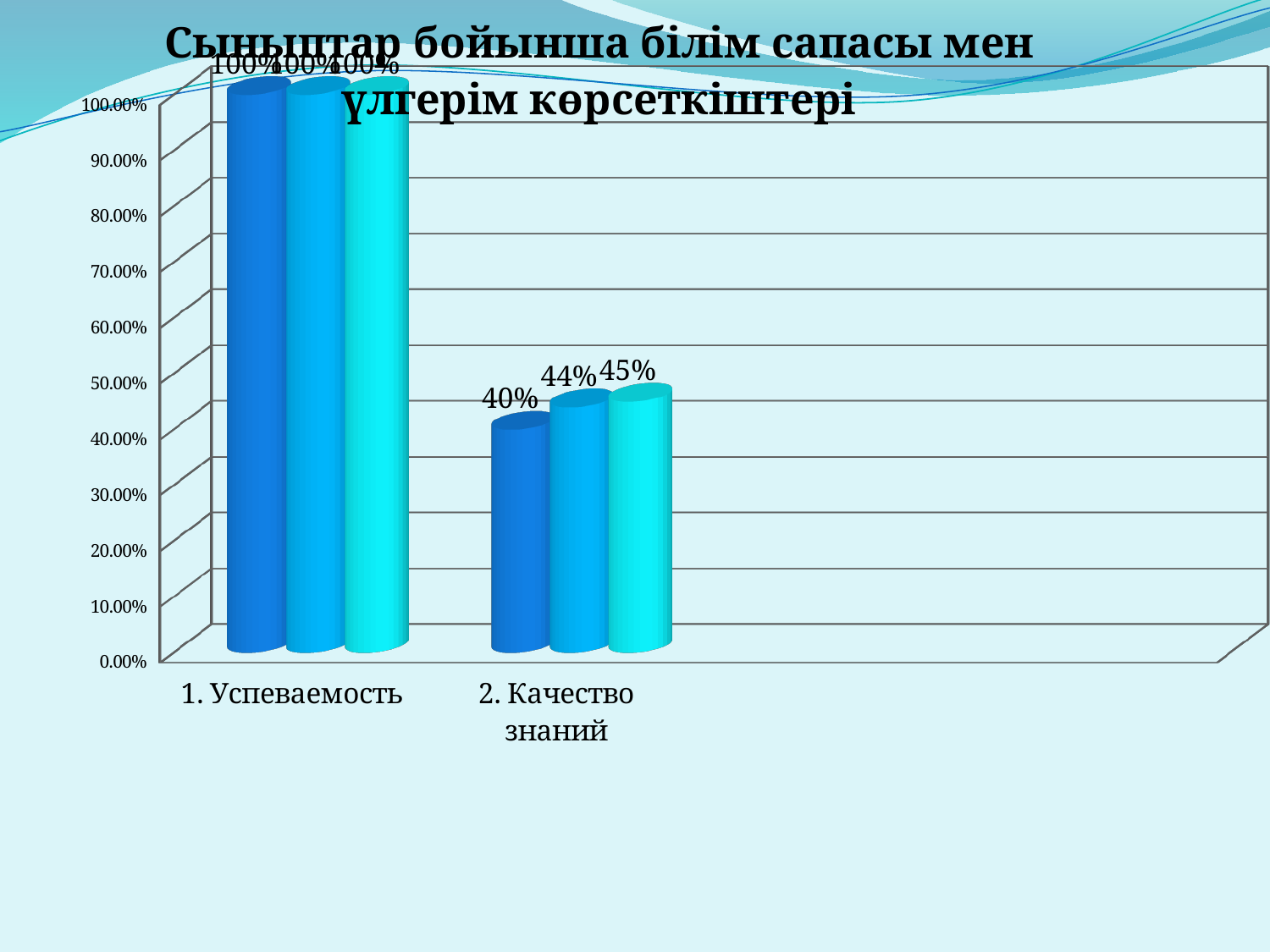
What is the value of the rightmost (cyan) bar for "2. Качество знаний"? 45% Which category has the higher values, "1. Успеваемость" or "2. Качество знаний"? 1. Успеваемость Are the values for "2. Качество знаний" greater or less than 50%? less What kind of chart is shown on the slide? bar chart What value is shown for each of the bars in the category "1. Успеваемость"? 100% What is the value of the first (leftmost, dark blue) bar for "2. Качество знаний"? 40% How many categories are shown on the x axis of the chart? 2 What is the difference between the 100% bar for "1. Успеваемость" and the 40% bar for "2. Качество знаний"? 60 percentage points What is the title of the chart on the slide? Сыныптар бойынша білім сапасы мен үлгерім көрсеткіштері How many bars are plotted for the category "2. Качество знаний"? 3 What is the difference between the highest and lowest bars in "2. Качество знаний" (45% and 40%)? 5 percentage points What is the value of the middle bar for "2. Качество знаний"? 44%